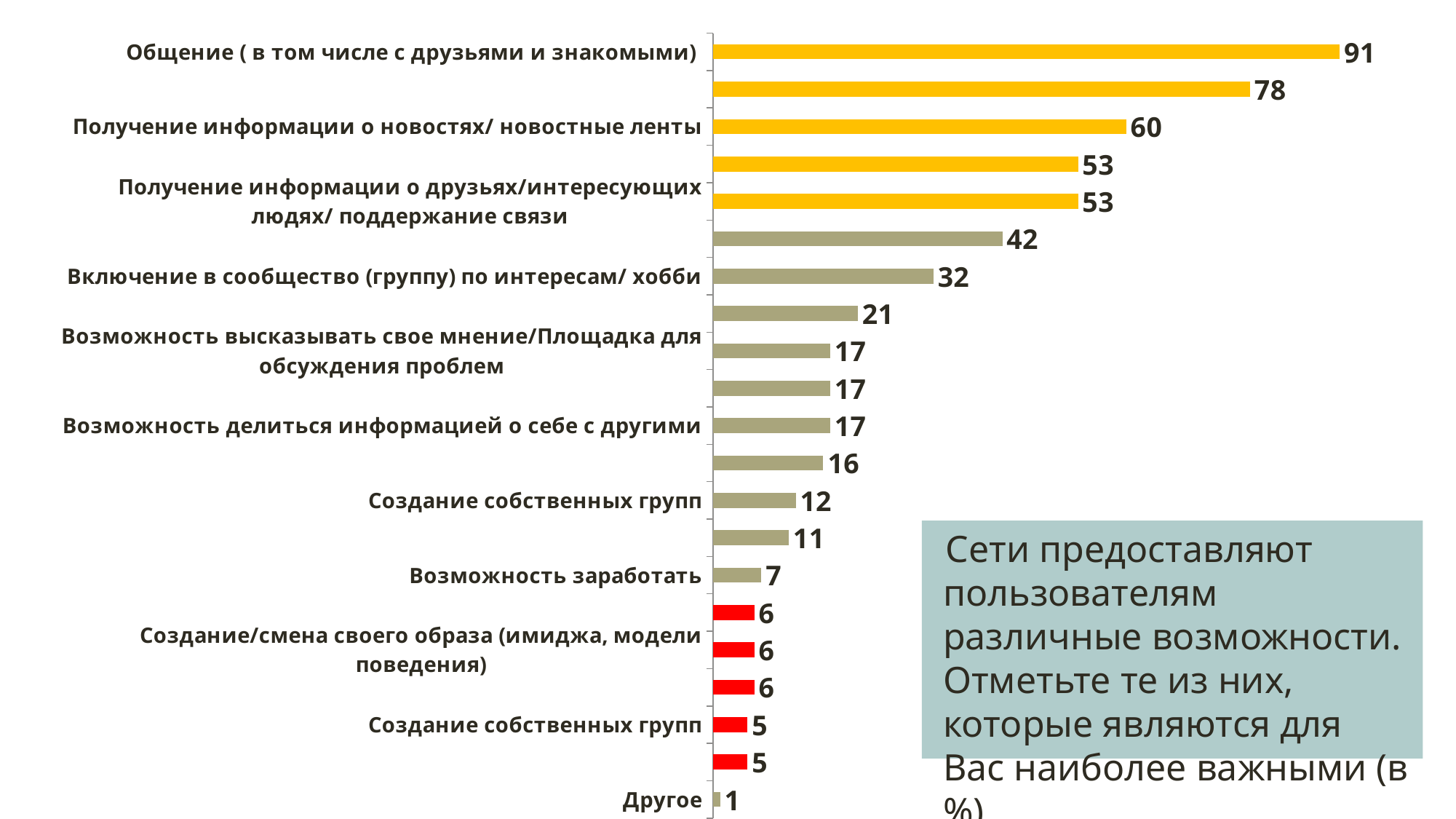
What value is shown for "Общение ( в том числе с друзьями и знакомыми)"? 91 What value is shown for "Получение информации о новостях/ новостные ленты"? 60 Which is larger: the value for "Включение в сообщество (группу) по интересам/ хобби" or for "Возможность заработать"? Включение в сообщество (группу) по интересам/ хобби Which category has the lowest value? Другое What value is shown for "Включение в сообщество (группу) по интересам/ хобби"? 32 What is the difference between the values for "Общение ( в том числе с друзьями и знакомыми)" and "Получение информации о новостях/ новостные ленты"? 31 How many bars are plotted in the chart? 21 What value is shown for "Другое"? 1 Which category has the highest value? Общение ( в том числе с друзьями и знакомыми) What kind of chart is shown on the slide? Bar chart What value is shown for "Возможность заработать"? 7 What colour are the bars with the lowest values (5 and 6) at the bottom of the chart? Red